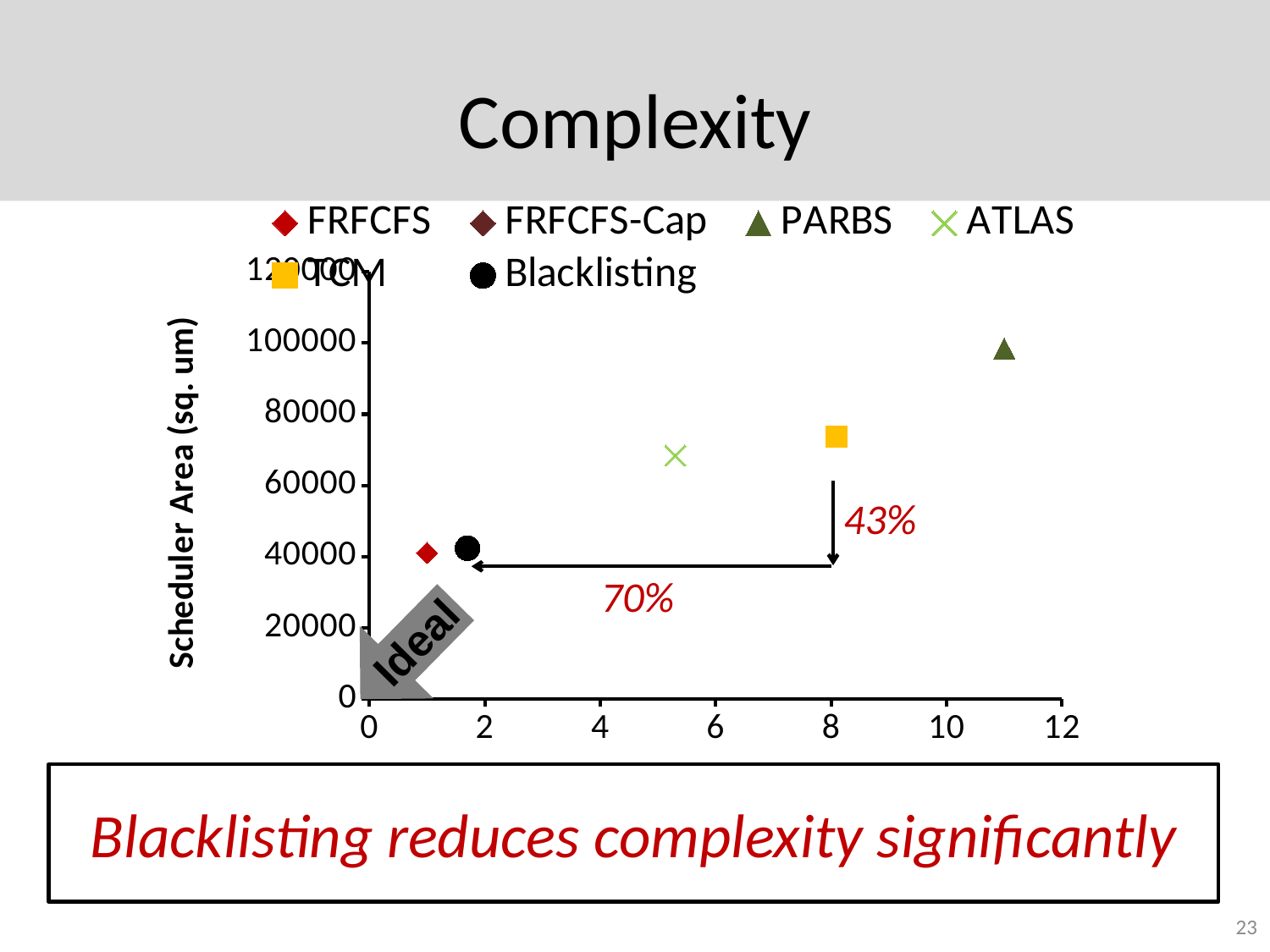
Which has a larger Scheduler Area, ATLAS or Blacklisting? ATLAS How many series does the legend list? 6 What percentage is written next to the horizontal arrow pointing from TCM toward Blacklisting? 70% Is the Scheduler Area for TCM greater or less than 60000? greater Is the Scheduler Area for ATLAS greater or less than 80000? less What kind of chart is shown on the slide? scatter chart Is the Scheduler Area for PARBS greater or less than 80000? greater What is the title of the y axis? Scheduler Area (sq. um) Which series has the highest Scheduler Area? PARBS Which has a larger Scheduler Area, PARBS or TCM? PARBS